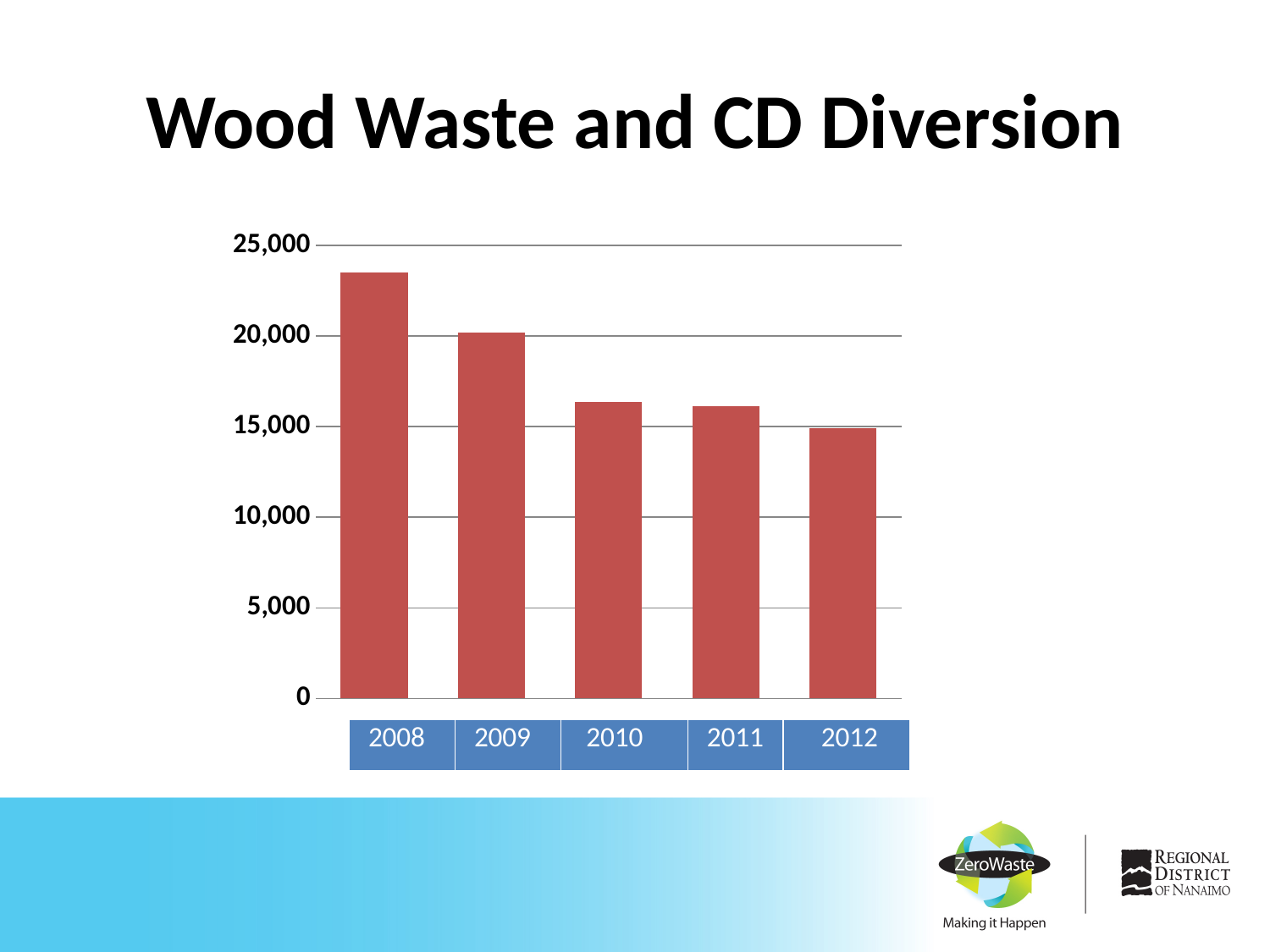
Do the values rise or fall from 2008 to 2012? fall Which is larger, the value for 2009 or the value for 2012? 2009 What is the title of the chart on the slide? Wood Waste and CD Diversion Is the value for 2011 greater or less than 20,000? less Which year has the highest value in the chart? 2008 How many years are shown on the x axis of the chart? 5 Is the value for 2008 greater or less than 25,000? less What kind of chart is shown on the slide? bar chart Which is larger, the value for 2008 or the value for 2009? 2008 Is the value for 2010 greater or less than 15,000? greater Which year has the lowest value in the chart? 2012